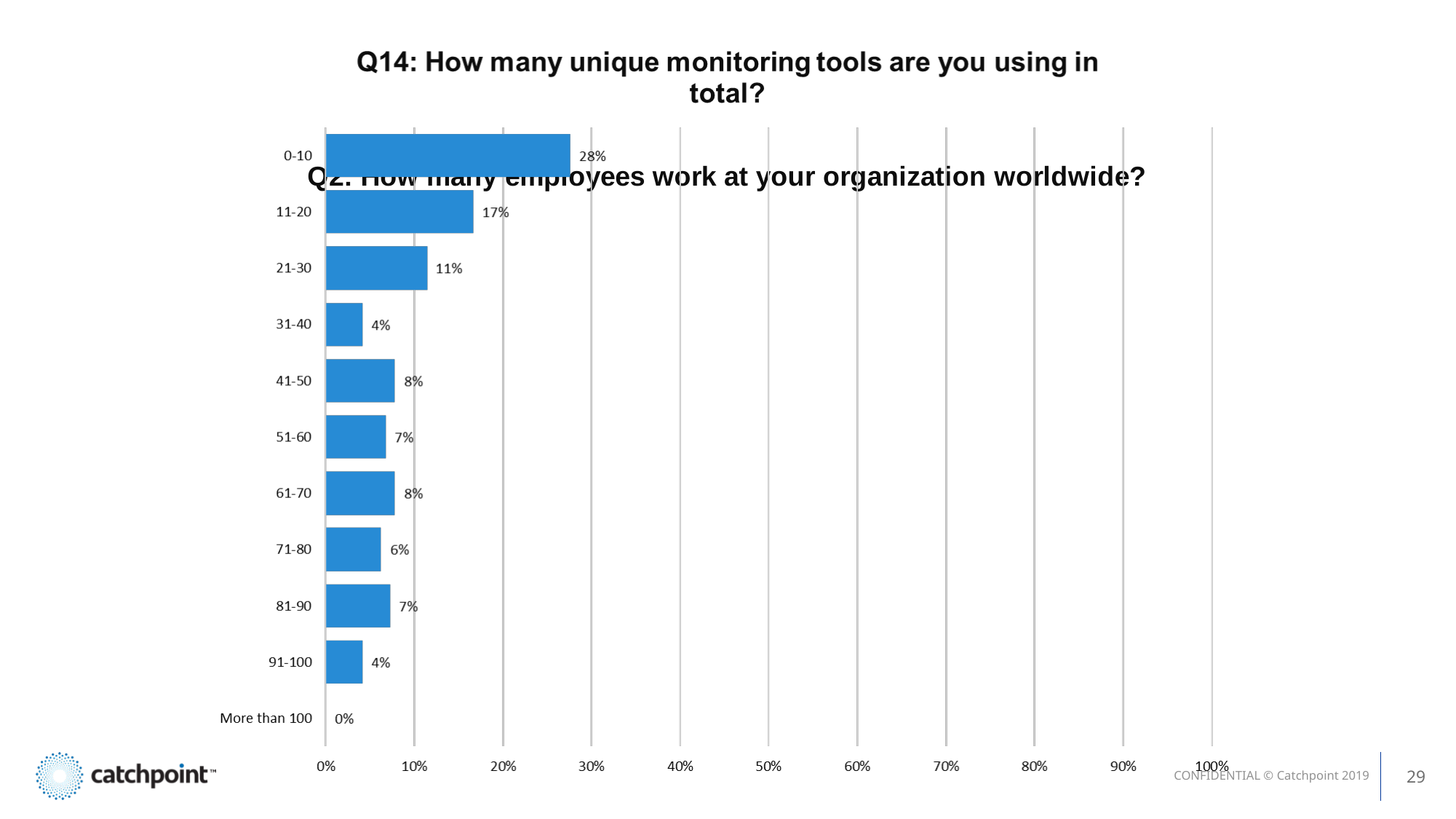
Which category has the highest percentage? 0-10 What is the difference in percentage points between the 0-10 and 11-20 categories? 11 What is the value shown for the 11-20 category? 17% Which category has the lowest percentage? More than 100 What percentage of respondents use 0-10 unique monitoring tools? 28% How many categories are shown on the chart? 11 What is the maximum value shown on the horizontal axis? 100% What is the value for the 'More than 100' category? 0% Which is larger, the value for 41-50 or the value for 71-80? 41-50 What percentage is shown for the 21-30 category? 11% Is the value for 0-10 greater or less than 20%? greater What kind of chart is shown on the slide? Bar chart